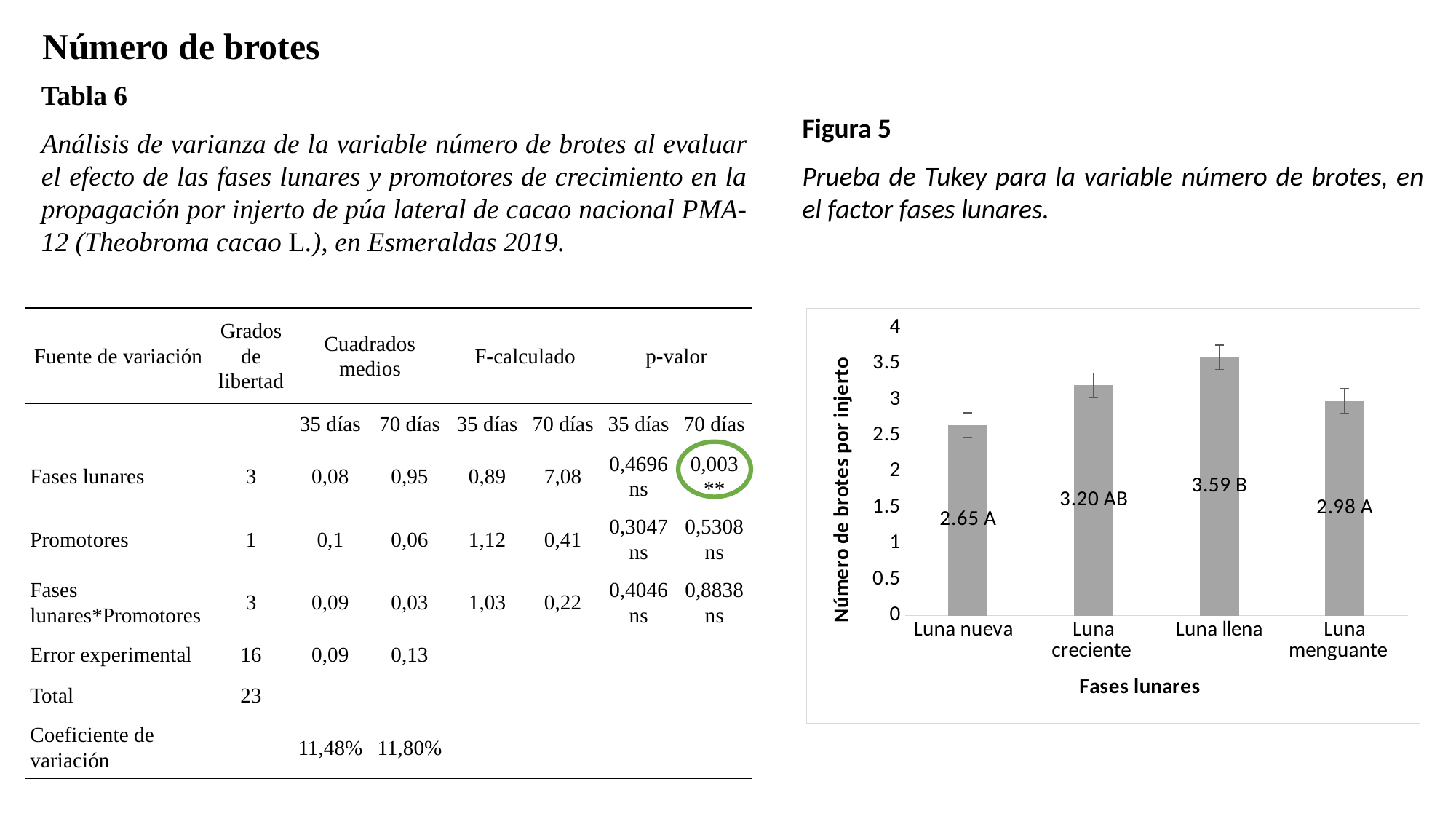
What is the y-axis title of the Figura 5 chart? Número de brotes por injerto In the Figura 5 chart, which is larger, the value for Luna creciente or the value for Luna menguante? Luna creciente How many lunar phases are shown on the x axis of the Figura 5 chart? 4 What is the value for Luna menguante in the Figura 5 bar chart? 2.98 What is the difference between the values for Luna creciente and Luna menguante in the Figura 5 chart? 0.22 What is the difference between the values for Luna llena and Luna nueva in the Figura 5 chart? 0.94 Which lunar phase has the lowest number of brotes por injerto in the Figura 5 chart? Luna nueva What kind of chart is Figura 5? bar chart What is the value for Luna llena in the Figura 5 bar chart? 3.59 Which lunar phase has the highest number of brotes por injerto in the Figura 5 chart? Luna llena What is the value for Luna nueva in the Figura 5 bar chart? 2.65 In the Figura 5 chart, is the value for Luna nueva greater or less than 3? less